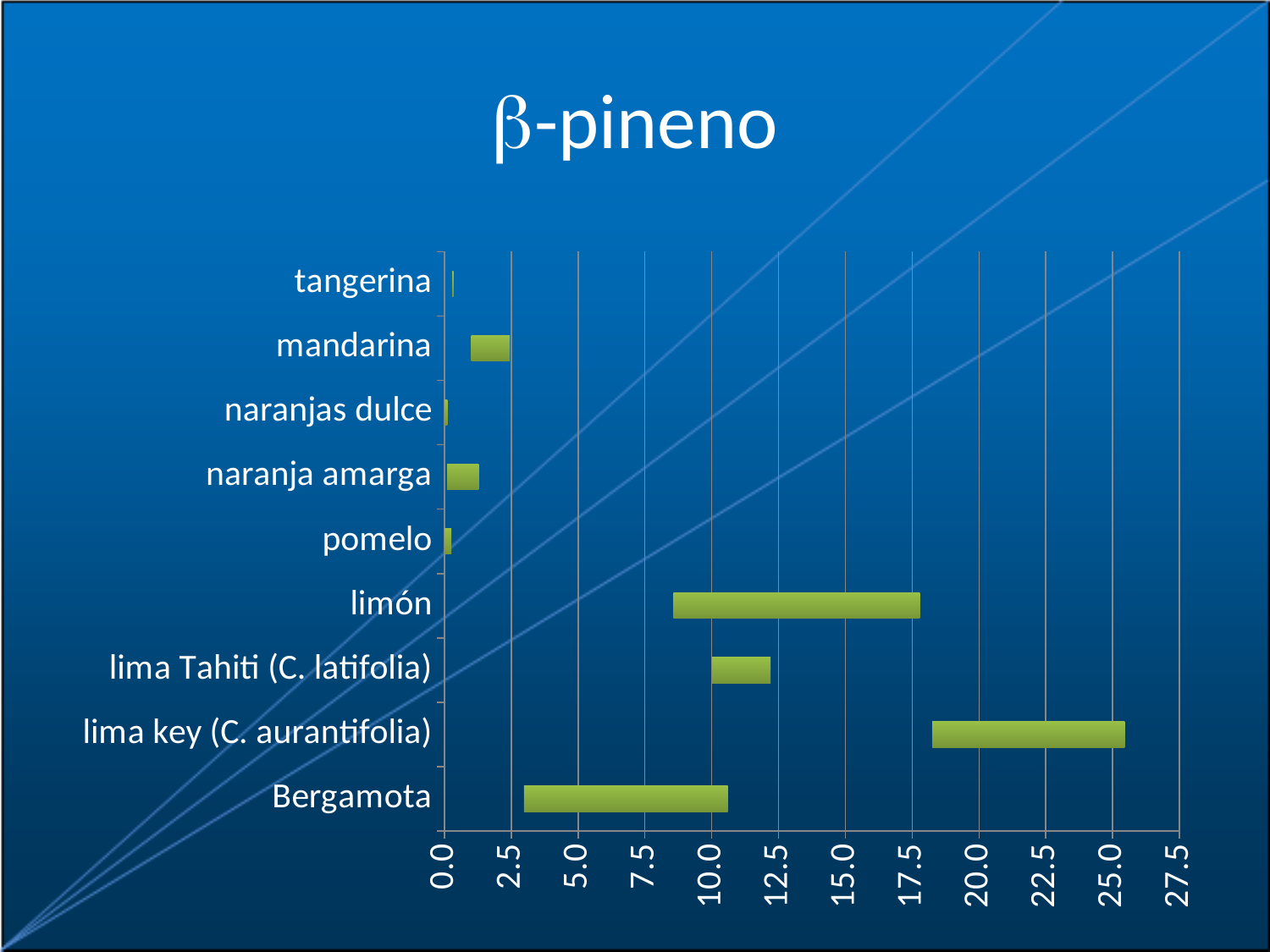
What is the highest value shown on the horizontal axis? 27.5 Is the right end of the bar for lima key (C. aurantifolia) greater or less than 25.0? greater Which bar reaches further to the right: mandarina or naranja amarga? mandarina Which bar reaches further to the right: limón or lima Tahiti (C. latifolia)? limón Is the right end of the bar for lima Tahiti (C. latifolia) greater or less than 12.5? less What is the title of the chart? β-pineno Which category's bar extends furthest to the right on the axis? lima key (C. aurantifolia) Is the right end of the bar for limón greater or less than 17.5? greater What kind of chart is shown on the slide? bar chart How many categories are shown on the chart? 9